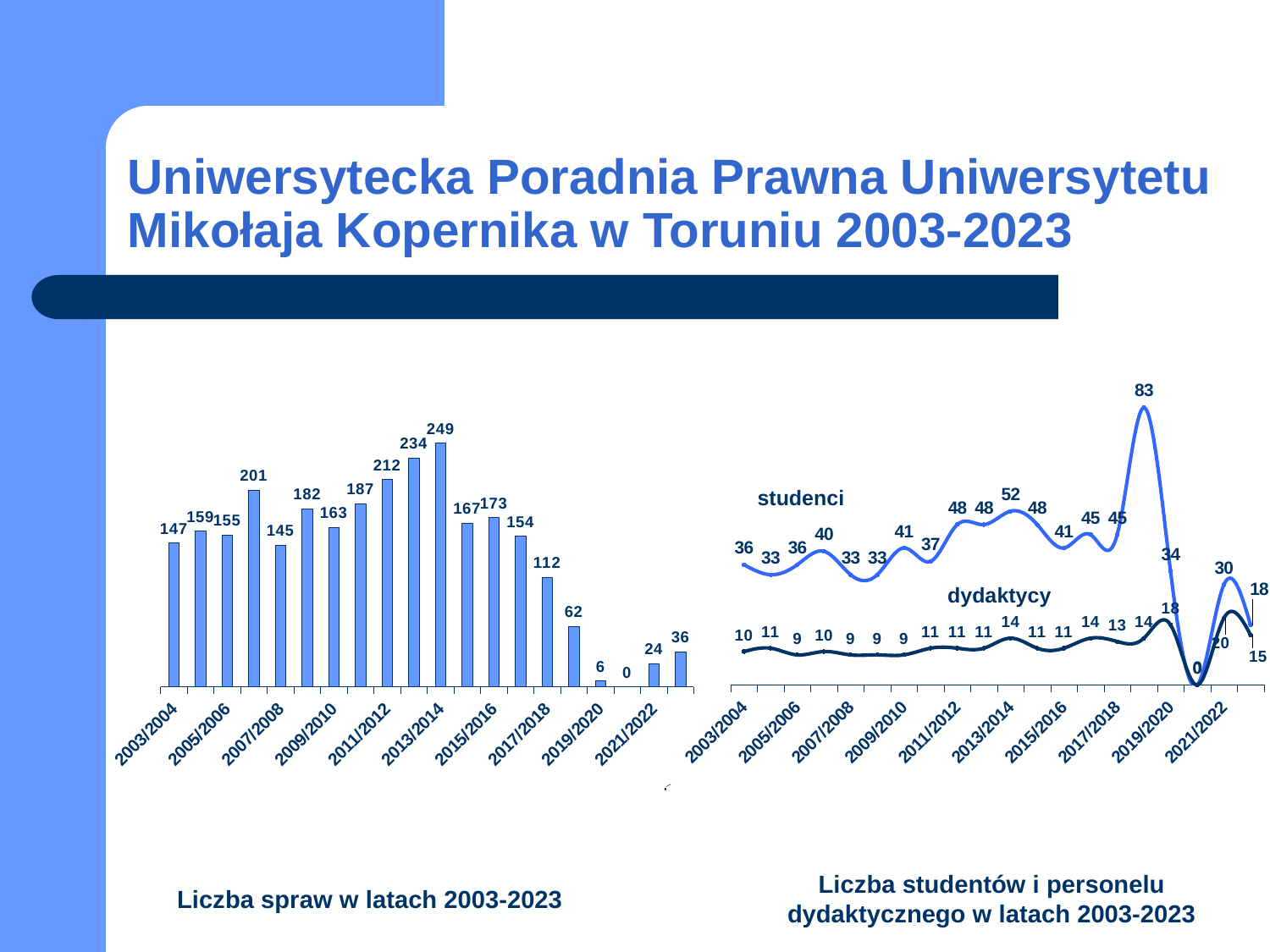
What kind of chart is the right chart, 'Liczba studentów i personelu dydaktycznego w latach 2003-2023'? line chart In the right chart 'Liczba studentów i personelu dydaktycznego w latach 2003-2023', what is the highest value of the 'studenci' series? 83 In the left chart 'Liczba spraw w latach 2003-2023', what is the value for 2011/2012? 212 What kind of chart is the left chart, 'Liczba spraw w latach 2003-2023'? bar chart In the left chart 'Liczba spraw w latach 2003-2023', what is the value for 2017/2018? 112 In the right chart 'Liczba studentów i personelu dydaktycznego w latach 2003-2023', what is the value of 'dydaktycy' for 2013/2014? 14 In the left chart 'Liczba spraw w latach 2003-2023', what is the highest value shown? 249 How many series are plotted in the right chart 'Liczba studentów i personelu dydaktycznego w latach 2003-2023'? 2 In the left chart 'Liczba spraw w latach 2003-2023', what is the difference between the value for 2013/2014 and the value for 2003/2004? 102 In the right chart 'Liczba studentów i personelu dydaktycznego w latach 2003-2023', which series has the larger value for 2011/2012, 'studenci' or 'dydaktycy'? studenci How many bars are plotted in the left chart 'Liczba spraw w latach 2003-2023'? 20 In the left chart 'Liczba spraw w latach 2003-2023', what is the value for 2003/2004? 147